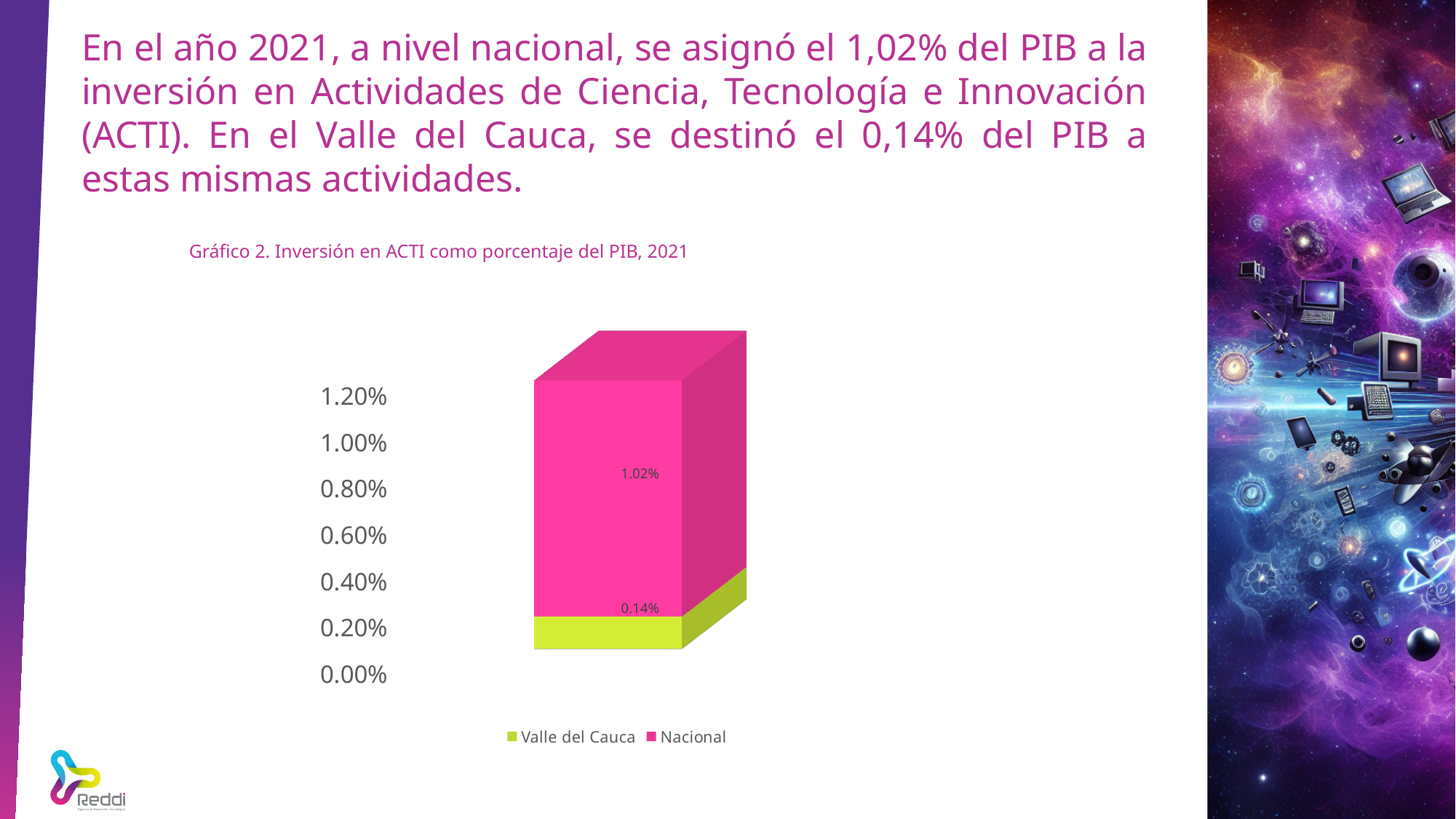
What value is shown for the Nacional series in the chart? 1.02% What value is shown for the Valle del Cauca series in the chart? 0.14% Which series has the smallest value in the chart? Valle del Cauca What is the difference between the Nacional value and the Valle del Cauca value? 0.88% What colour represents the Valle del Cauca series in the chart? Yellow-green Is the value for Nacional greater or less than 1.00%? greater Which series has the larger value, Nacional or Valle del Cauca? Nacional What is the total of the stacked bar (Valle del Cauca plus Nacional)? 1.16% How many series does the legend list? 2 What is the title of the chart? Gráfico 2. Inversión en ACTI como porcentaje del PIB, 2021 What kind of chart is shown on the slide? Stacked bar chart Which series has the highest value in the chart? Nacional